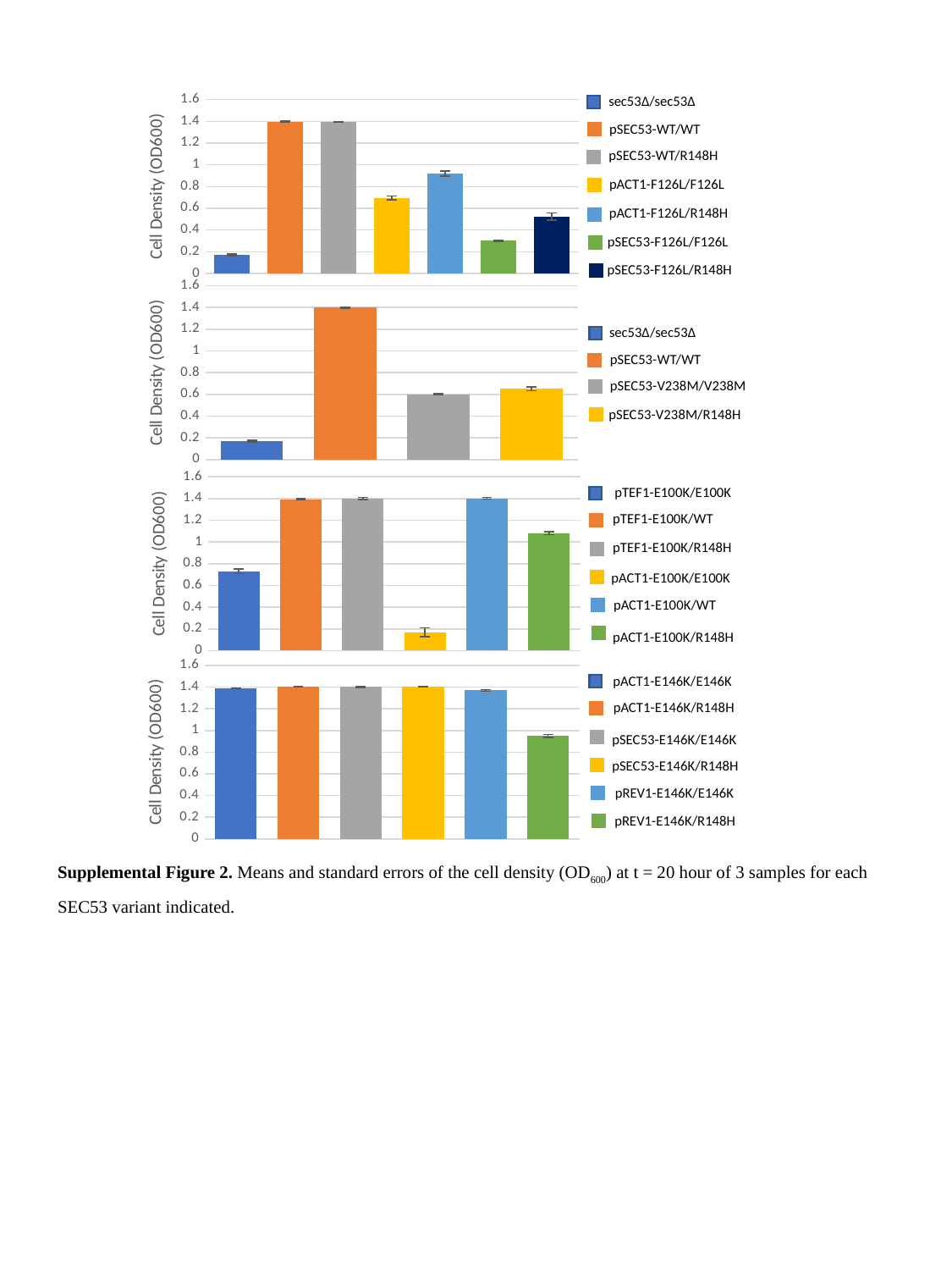
In the top chart, how many series does the legend list? 7 In the top chart, which is larger, pACT1-F126L/F126L or pSEC53-F126L/F126L? pACT1-F126L/F126L In the second chart from the top, is the value for pSEC53-V238M/V238M greater or less than 0.8? less In the top chart, which series has the lowest cell density? sec53Δ/sec53Δ In the bottom chart, which series has the lowest cell density? pREV1-E146K/R148H In the top chart, is the value for pACT1-F126L/R148H greater or less than 0.8? greater In the second chart from the top, which series has the highest cell density? pSEC53-WT/WT In the third chart from the top, which series has the lowest cell density? pACT1-E100K/E100K In the top chart, what kind of chart is used? bar chart In the third chart from the top, is the value for pTEF1-E100K/E100K greater or less than 0.6? greater In the second chart from the top, how many series does the legend list? 4 How many charts are shown on the slide? 4